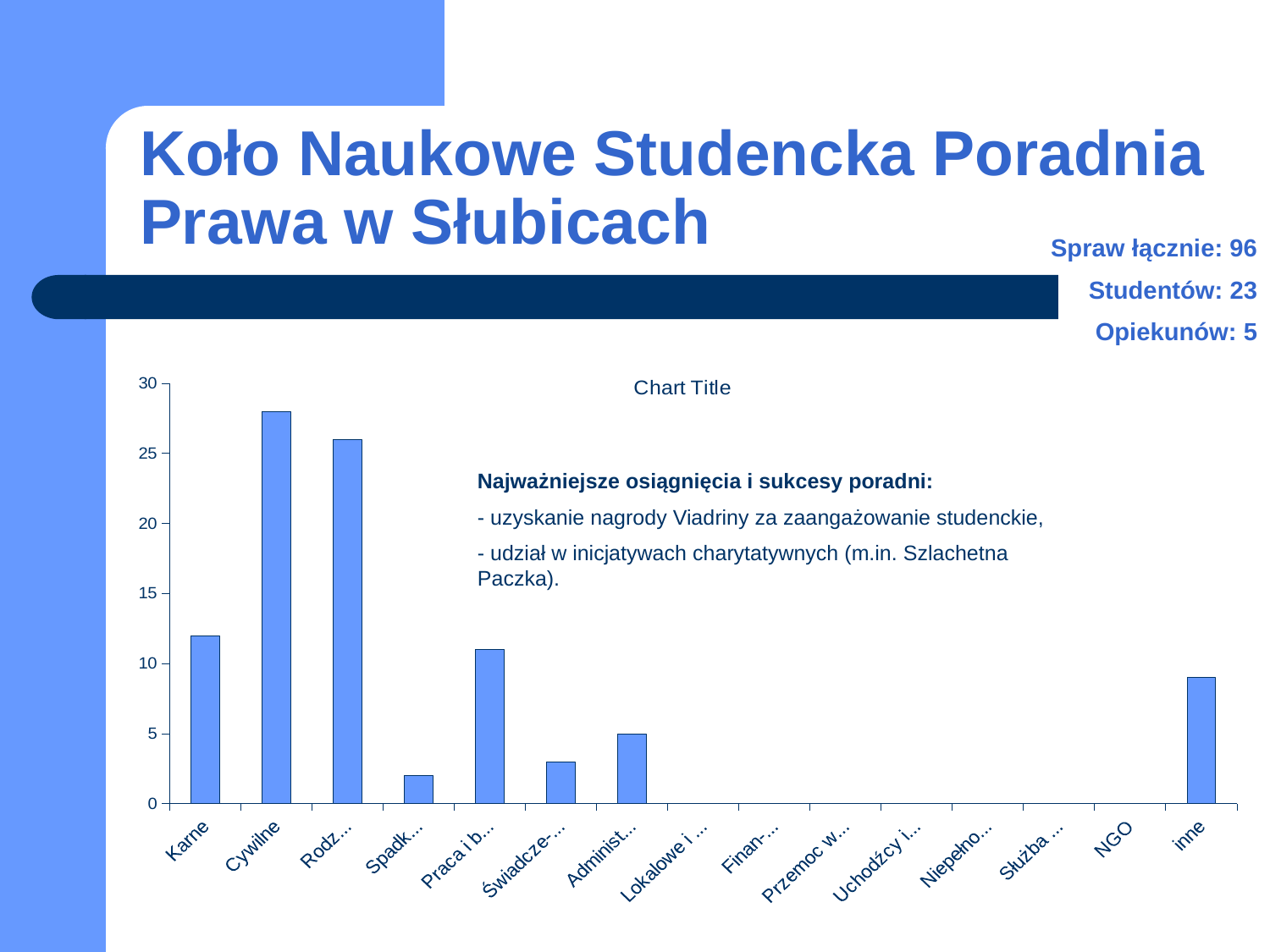
Is the value for Spadk... greater or less than 5? less Is the value for inne greater or less than 10? less Is the value for Praca i b... greater or less than 15? less Which is larger, the value for Cywilne or the value for Karne? Cywilne How many categories are shown on the x axis of the chart? 15 Which is larger, the value for Karne or the value for inne? Karne What kind of chart is shown on the slide? bar chart Which category has the highest bar in the chart? Cywilne What is the title shown above the chart? Chart Title